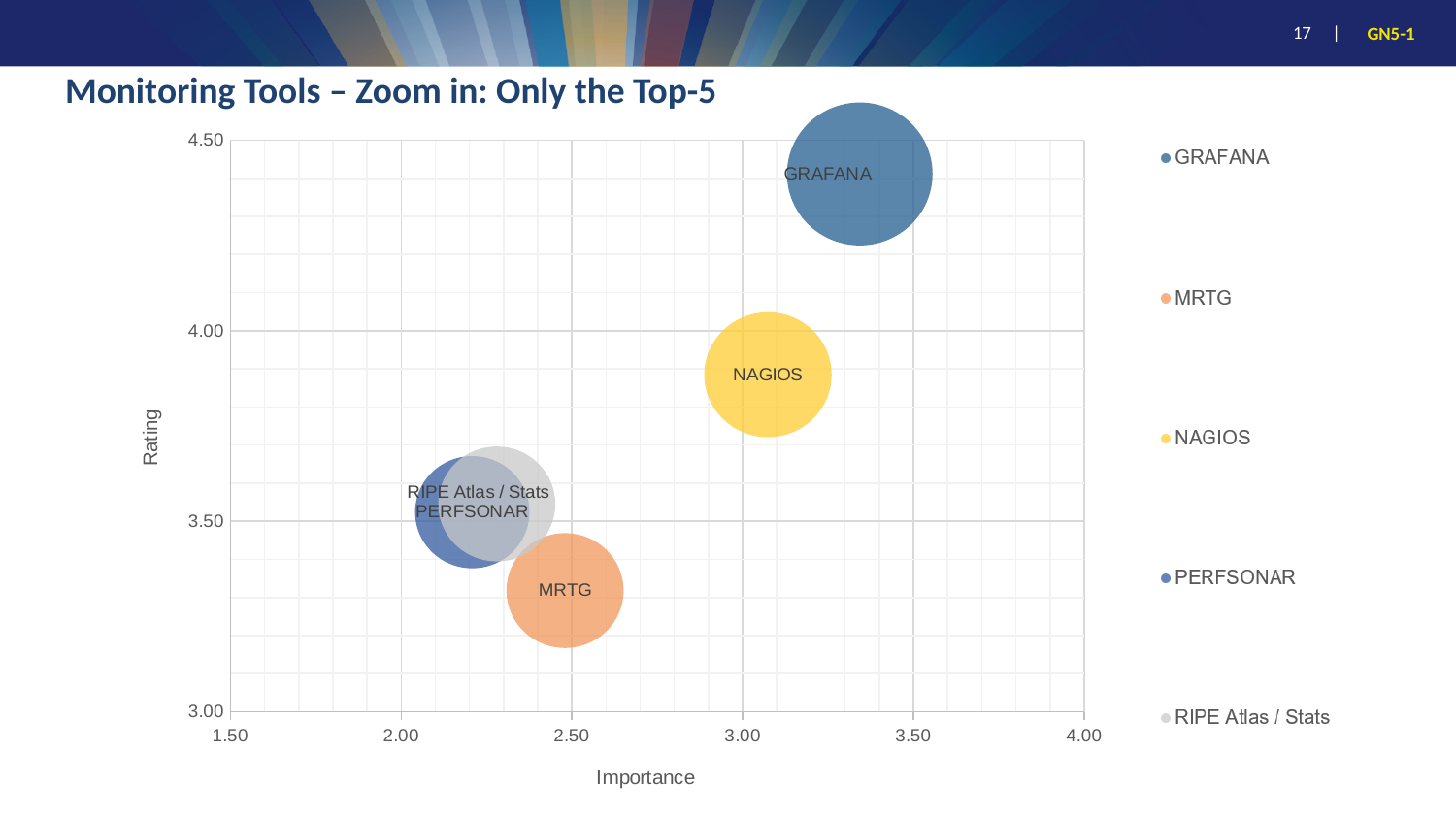
How many entries does the legend list? 5 What kind of chart is shown on the slide? Bubble chart Which tool has the highest Rating? GRAFANA Which tool has the lowest Rating? MRTG What is the title of the chart on the slide? Monitoring Tools – Zoom in: Only the Top-5 Is the Rating for GRAFANA greater or less than 4.00? greater Which has the higher Rating, NAGIOS or MRTG? NAGIOS Which tool has the highest Importance? GRAFANA How many monitoring tools are plotted on the chart? 5 Is the Rating for MRTG greater or less than 3.50? less What is the label of the horizontal axis? Importance Is the Importance for PERFSONAR greater or less than 2.50? less